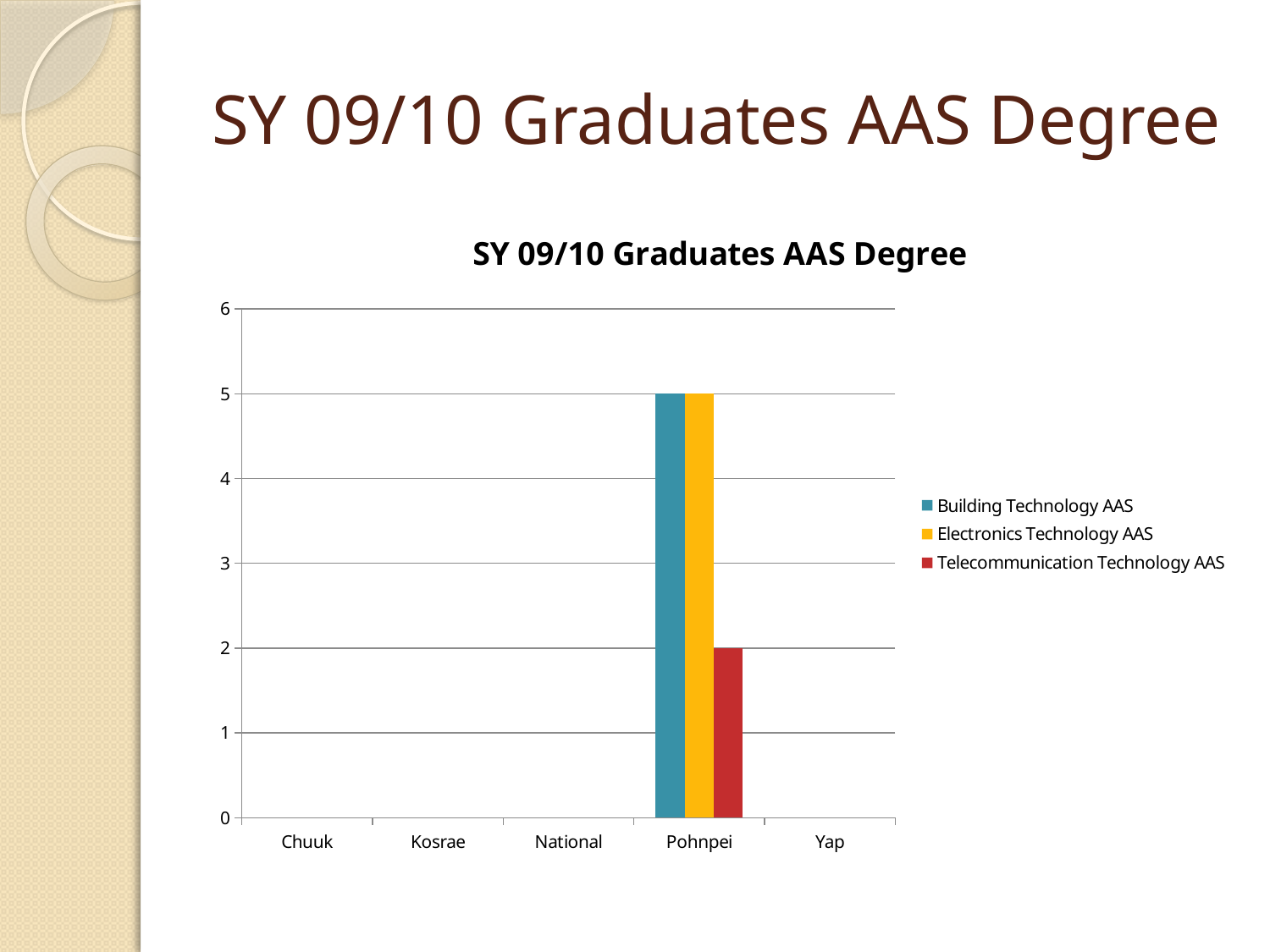
What is the value for Telecommunication Technology AAS in Pohnpei? 2 Which category has the highest values in the chart? Pohnpei Which series has the lowest value in Pohnpei? Telecommunication Technology AAS What is the difference between the Building Technology AAS and Telecommunication Technology AAS values in Pohnpei? 3 What type of chart is shown on the slide? Bar chart What is the title of the chart? SY 09/10 Graduates AAS Degree How many categories are shown on the x axis? 5 Which series is shown in red in the legend? Telecommunication Technology AAS What is the value for Building Technology AAS in Pohnpei? 5 Which is larger in Pohnpei: Electronics Technology AAS or Telecommunication Technology AAS? Electronics Technology AAS What is the value for Electronics Technology AAS in Pohnpei? 5 How many series does the legend list? 3